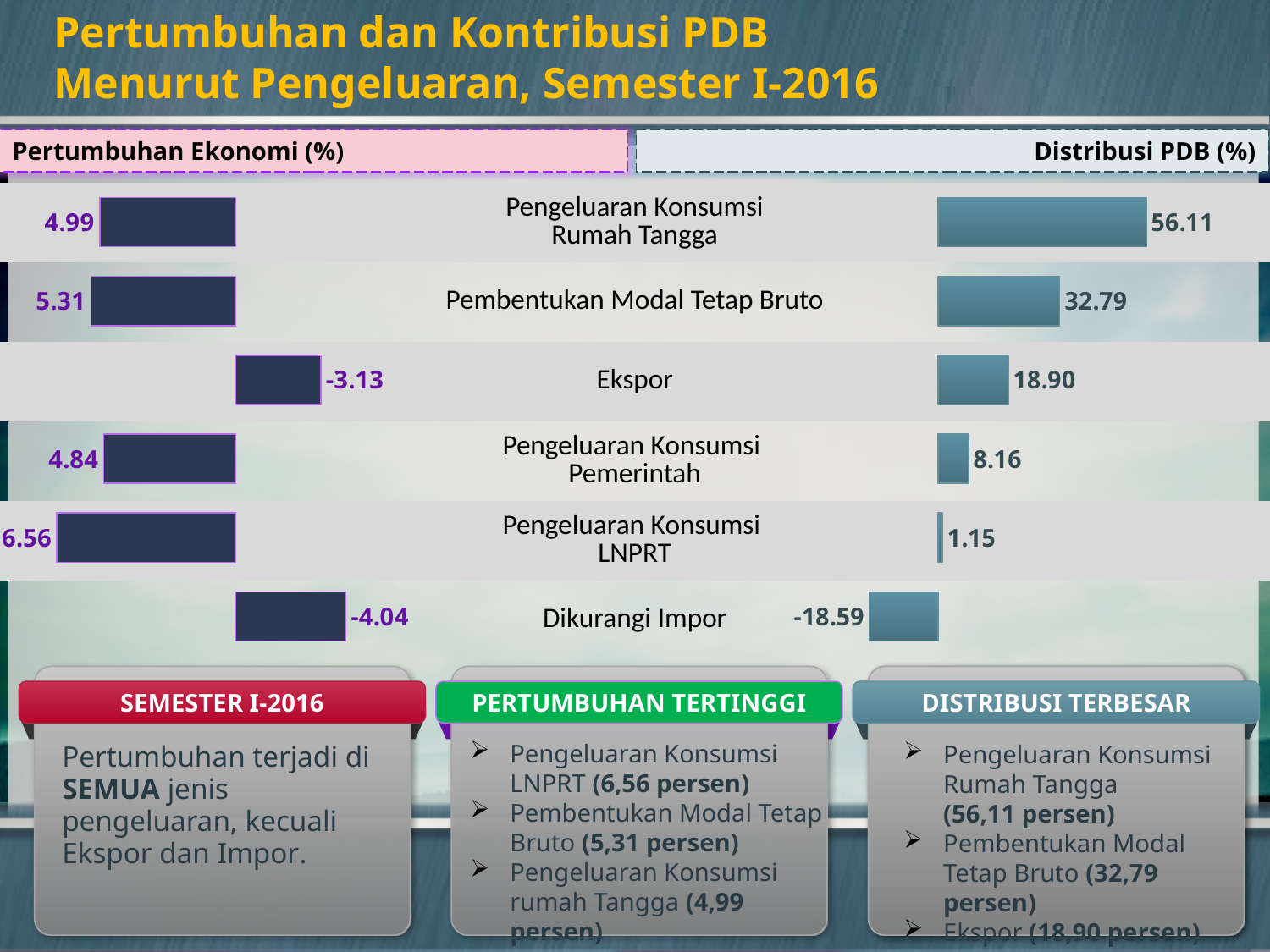
How many categories are shown in the Distribusi PDB (%) chart? 6 In the Pertumbuhan Ekonomi (%) chart, which category has the highest value? Pengeluaran Konsumsi LNPRT In the Distribusi PDB (%) chart, which category has the highest value? Pengeluaran Konsumsi Rumah Tangga In the Pertumbuhan Ekonomi (%) chart, which is larger: Pengeluaran Konsumsi Rumah Tangga or Pengeluaran Konsumsi Pemerintah? Pengeluaran Konsumsi Rumah Tangga In the Pertumbuhan Ekonomi (%) chart, which category has the lowest value? Dikurangi Impor In the Pertumbuhan Ekonomi (%) chart, what is the difference between Pengeluaran Konsumsi LNPRT and Pembentukan Modal Tetap Bruto? 1.25 In the Pertumbuhan Ekonomi (%) chart, what is the value for Ekspor? -3.13 In the Pertumbuhan Ekonomi (%) chart, what is the value for Pengeluaran Konsumsi LNPRT? 6.56 In the Distribusi PDB (%) chart, what is the value for Pembentukan Modal Tetap Bruto? 32.79 In the Distribusi PDB (%) chart, what is the difference between Pengeluaran Konsumsi Rumah Tangga and Pembentukan Modal Tetap Bruto? 23.32 In the Distribusi PDB (%) chart, what is the value for Dikurangi Impor? -18.59 What kind of chart is the Pertumbuhan Ekonomi (%) chart? Bar chart